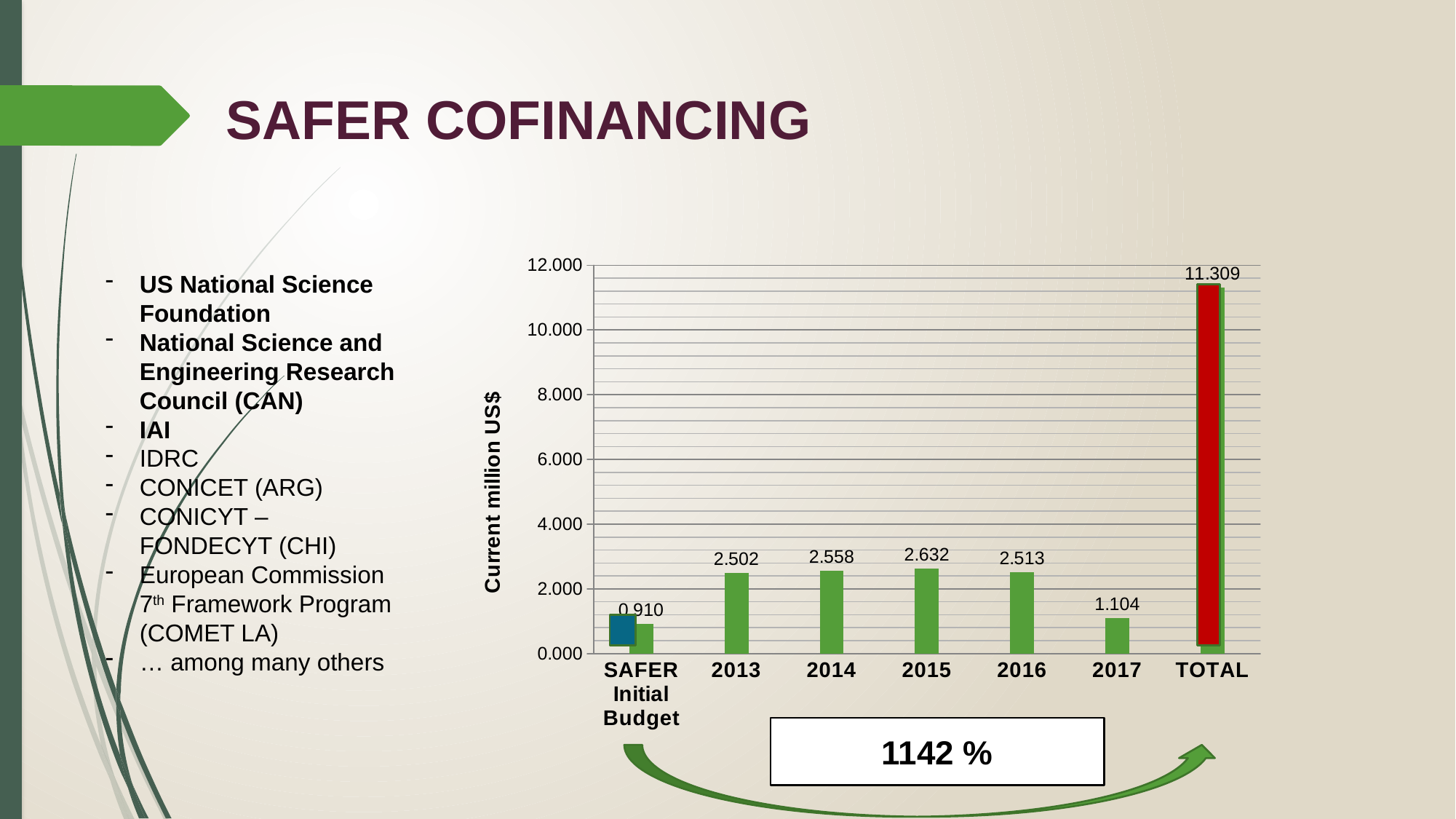
What is the value for 2014 on the chart? 2.558 Which is larger, the value for 2015 or the value for 2016? 2015 What is the value of the TOTAL bar? 11.309 What is the label of the vertical axis of the chart? Current million US$ What is the value shown for the SAFER Initial Budget bar? 0.910 What is the difference between the values for 2015 and 2014? 0.074 What kind of chart is shown on the slide? bar chart What is the difference between the values for 2013 and 2017? 1.398 How many categories are shown on the x axis of the chart? 7 Is the value for 2017 greater or less than 2.000? less Which category has the highest value on the chart? TOTAL Which category has the lowest value on the chart? SAFER Initial Budget